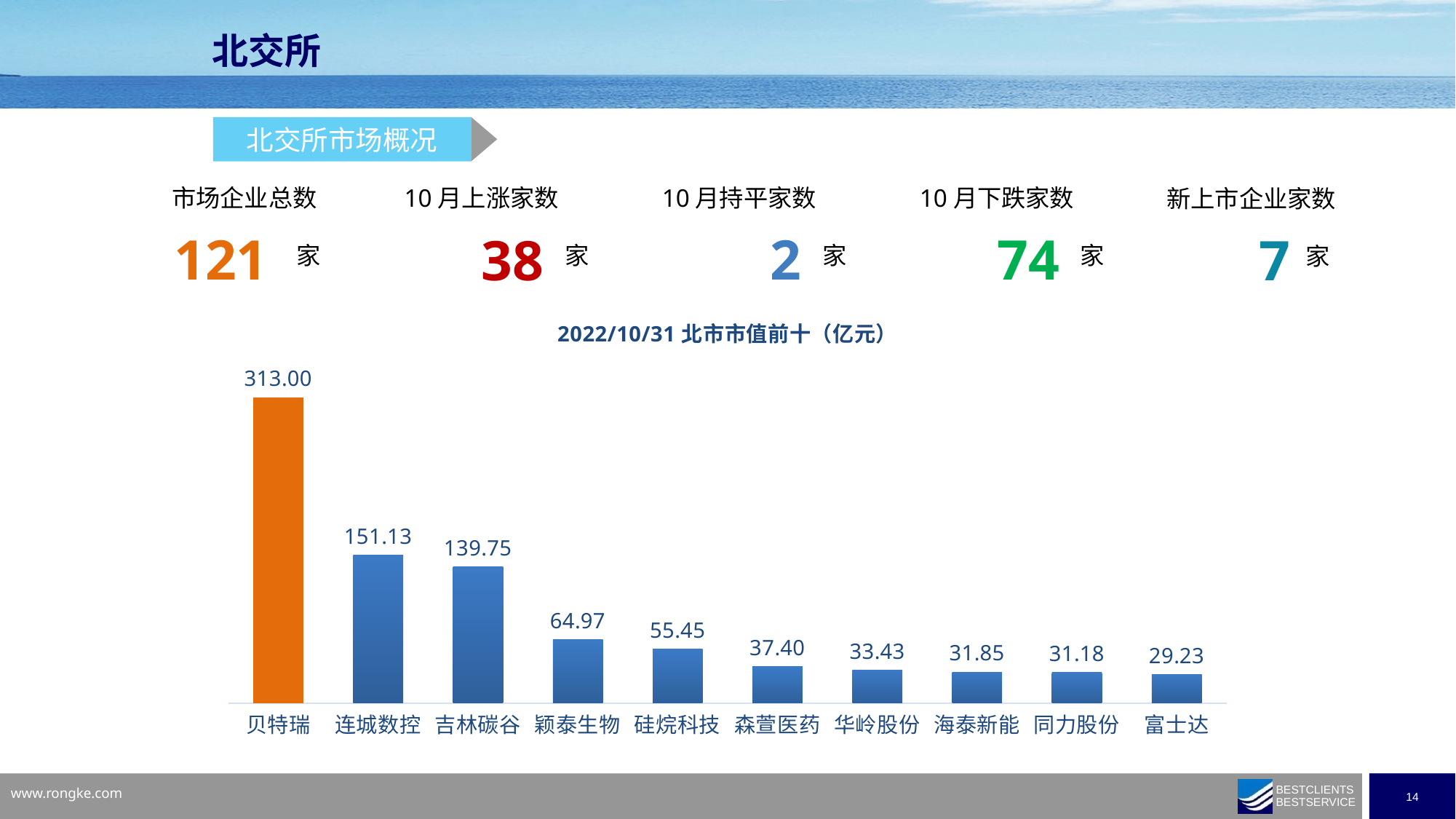
Which company has the lowest market value in the chart? 富士达 What is the difference between the values for 贝特瑞 and 连城数控? 161.87 How many companies are shown in the chart? 10 What type of chart is shown on the slide? Bar chart Which company has the highest market value in the chart? 贝特瑞 What value is labelled for 连城数控? 151.13 What is the market value shown for 贝特瑞 in the chart? 313.00 What is the difference between the values for 连城数控 and 吉林碳谷? 11.38 Which has a larger value, 颖泰生物 or 森萱医药? 颖泰生物 What is the value shown for 硅烷科技? 55.45 What value does the chart show for 富士达? 29.23 What is the title of the chart? 2022/10/31 北市市值前十（亿元）